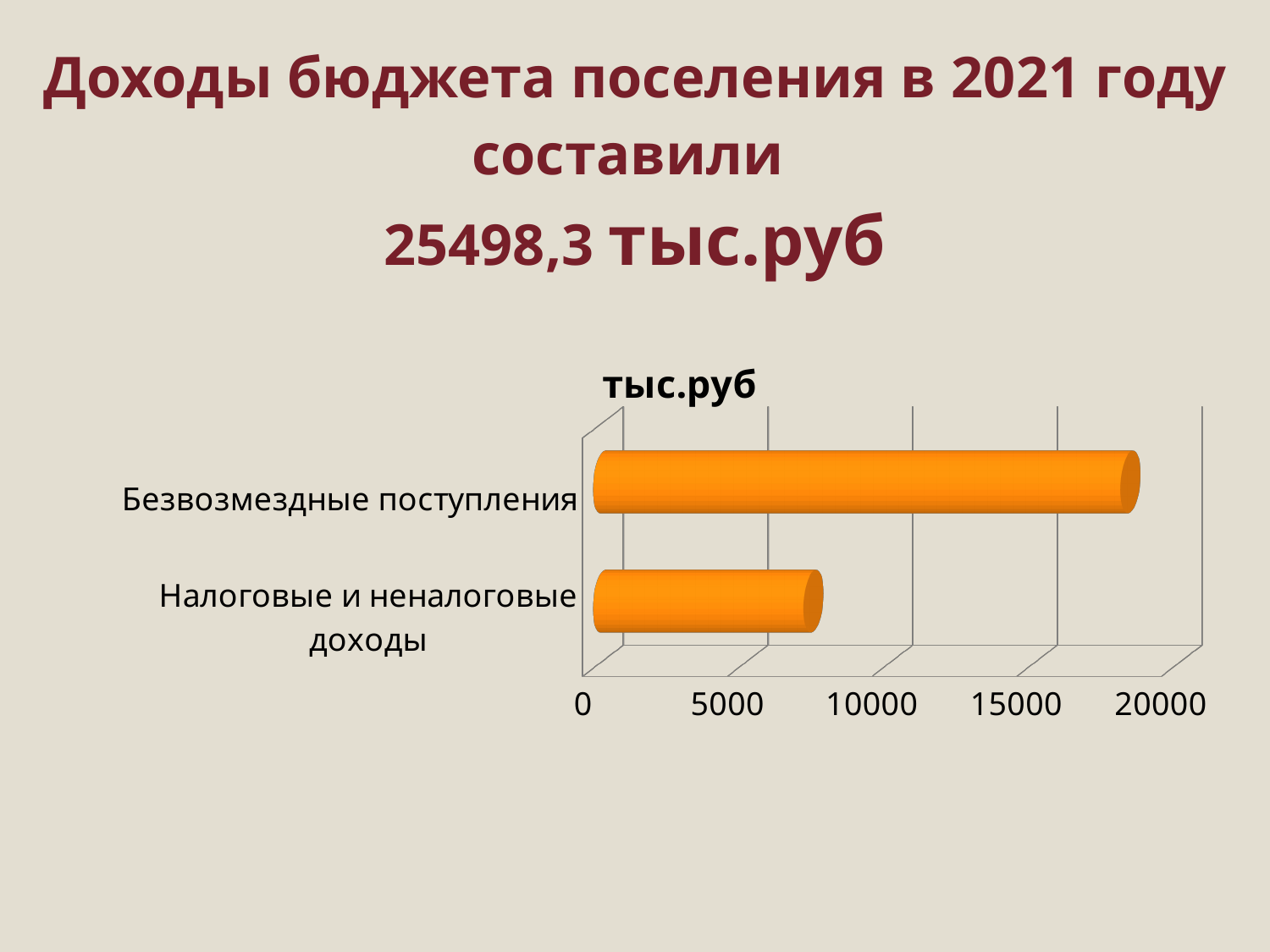
What is the highest tick value shown on the horizontal axis? 20000 Which category has the highest value? Безвозмездные поступления Which is larger: the value for Безвозмездные поступления or the value for Налоговые и неналоговые доходы? Безвозмездные поступления Is the value for Налоговые и неналоговые доходы greater or less than 5000? greater How many categories does the chart show? 2 Is the value for Безвозмездные поступления greater or less than 15000? greater What kind of chart is shown on the slide? bar chart Is the value for Налоговые и неналоговые доходы greater or less than 10000? less Which category has the lowest value? Налоговые и неналоговые доходы What is the title of the chart? тыс.руб